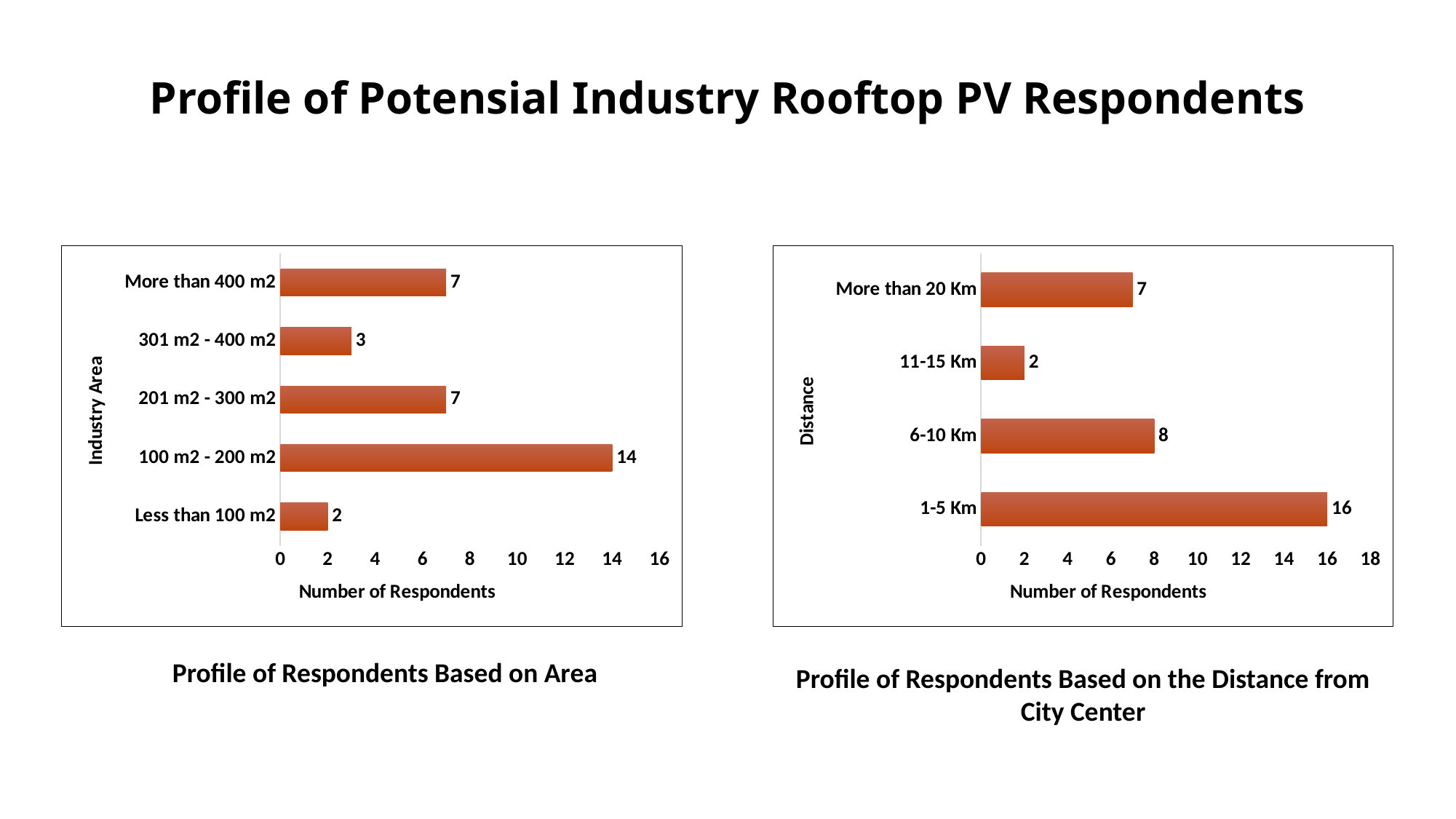
In the 'Profile of Respondents Based on the Distance from City Center' chart, which distance category has the highest number of respondents? 1-5 Km In the 'Profile of Respondents Based on the Distance from City Center' chart, what is the difference in respondents between 1-5 Km and 11-15 Km? 14 In the 'Profile of Respondents Based on Area' chart, what is the difference in respondents between 100 m2 - 200 m2 and 301 m2 - 400 m2? 11 In the 'Profile of Respondents Based on the Distance from City Center' chart, which distance category has the lowest number of respondents? 11-15 Km In the 'Profile of Respondents Based on the Distance from City Center' chart, which has more respondents: 6-10 Km or More than 20 Km? 6-10 Km In the 'Profile of Respondents Based on Area' chart, how many respondents are in the 100 m2 - 200 m2 category? 14 In the 'Profile of Respondents Based on Area' chart, which industry area category has the highest number of respondents? 100 m2 - 200 m2 In the 'Profile of Respondents Based on the Distance from City Center' chart, how many respondents are in the 6-10 Km category? 8 What is the x-axis label of the 'Profile of Respondents Based on the Distance from City Center' chart? Number of Respondents In the 'Profile of Respondents Based on Area' chart, which industry area category has the lowest number of respondents? Less than 100 m2 In the 'Profile of Respondents Based on Area' chart, how many categories are shown? 5 What type of chart is the 'Profile of Respondents Based on Area' chart? Bar chart